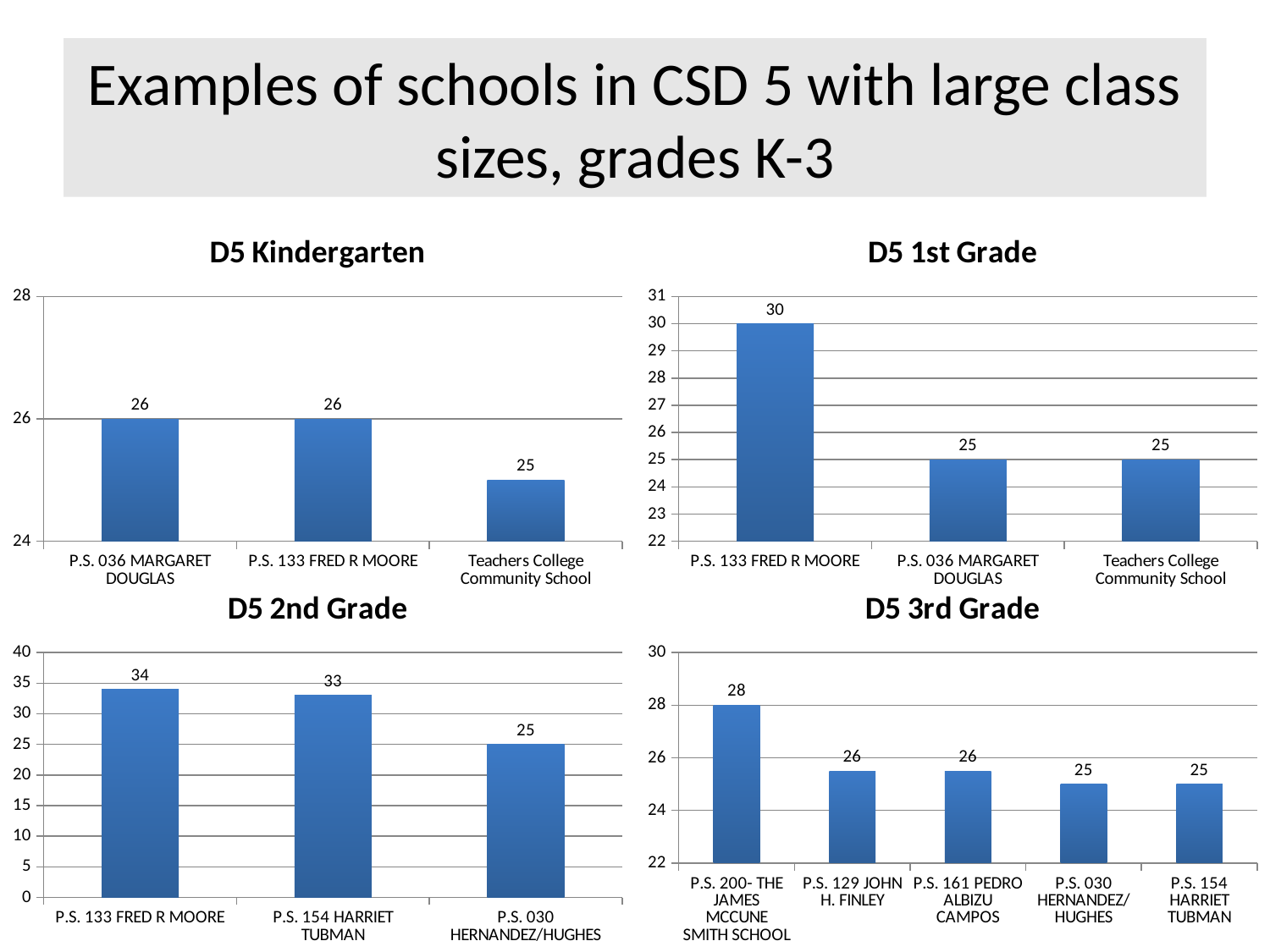
In the D5 2nd Grade chart, what is the difference between P.S. 133 FRED R MOORE and P.S. 030 HERNANDEZ/HUGHES? 9 What kind of chart is the D5 Kindergarten chart? Bar chart How many charts are on the slide? 4 In the D5 Kindergarten chart, what is the value for Teachers College Community School? 25 In the D5 2nd Grade chart, which school has the lowest value? P.S. 030 HERNANDEZ/HUGHES In the D5 1st Grade chart, what is the value for P.S. 133 FRED R MOORE? 30 In the D5 2nd Grade chart, what is the value for P.S. 154 HARRIET TUBMAN? 33 In the D5 3rd Grade chart, how many schools are shown? 5 In the D5 3rd Grade chart, what is the value for P.S. 200- THE JAMES MCCUNE SMITH SCHOOL? 28 In the D5 3rd Grade chart, which is larger: P.S. 200- THE JAMES MCCUNE SMITH SCHOOL or P.S. 154 HARRIET TUBMAN? P.S. 200- THE JAMES MCCUNE SMITH SCHOOL In the D5 1st Grade chart, what is the difference between P.S. 133 FRED R MOORE and P.S. 036 MARGARET DOUGLAS? 5 In the D5 1st Grade chart, which school has the highest value? P.S. 133 FRED R MOORE